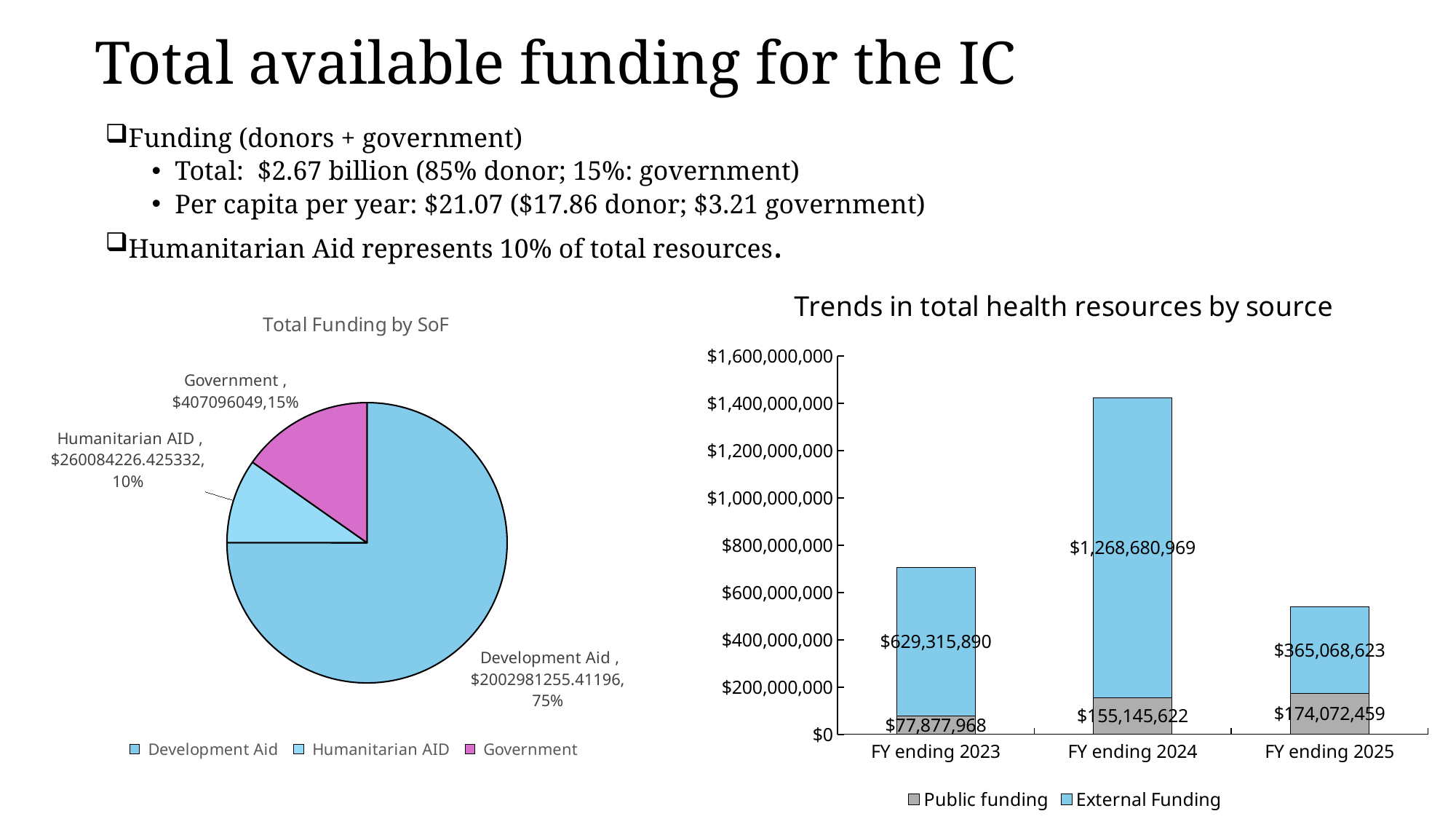
In the 'Trends in total health resources by source' chart, what is the total of the FY ending 2025 bar? $539,141,082 What type of chart is 'Trends in total health resources by source'? Stacked bar chart In the 'Trends in total health resources by source' chart, what is the Public funding value for FY ending 2023? $77,877,968 In the 'Trends in total health resources by source' chart, what is the External Funding value for FY ending 2024? $1,268,680,969 How many slices does the 'Total Funding by SoF' pie chart have? 3 In the 'Total Funding by SoF' pie chart, which source has the smallest slice? Humanitarian AID In the 'Trends in total health resources by source' chart, how much greater is External Funding in FY ending 2024 than in FY ending 2023? $639,365,079 In the 'Total Funding by SoF' pie chart, which source has the largest slice? Development Aid How many series does the legend of the 'Trends in total health resources by source' chart list? 2 In the 'Total Funding by SoF' pie chart, what share of total funding is Government? 15% In the 'Trends in total health resources by source' chart, which fiscal year has the highest External Funding? FY ending 2024 In the 'Total Funding by SoF' pie chart, what is the value shown for Government? $407096049